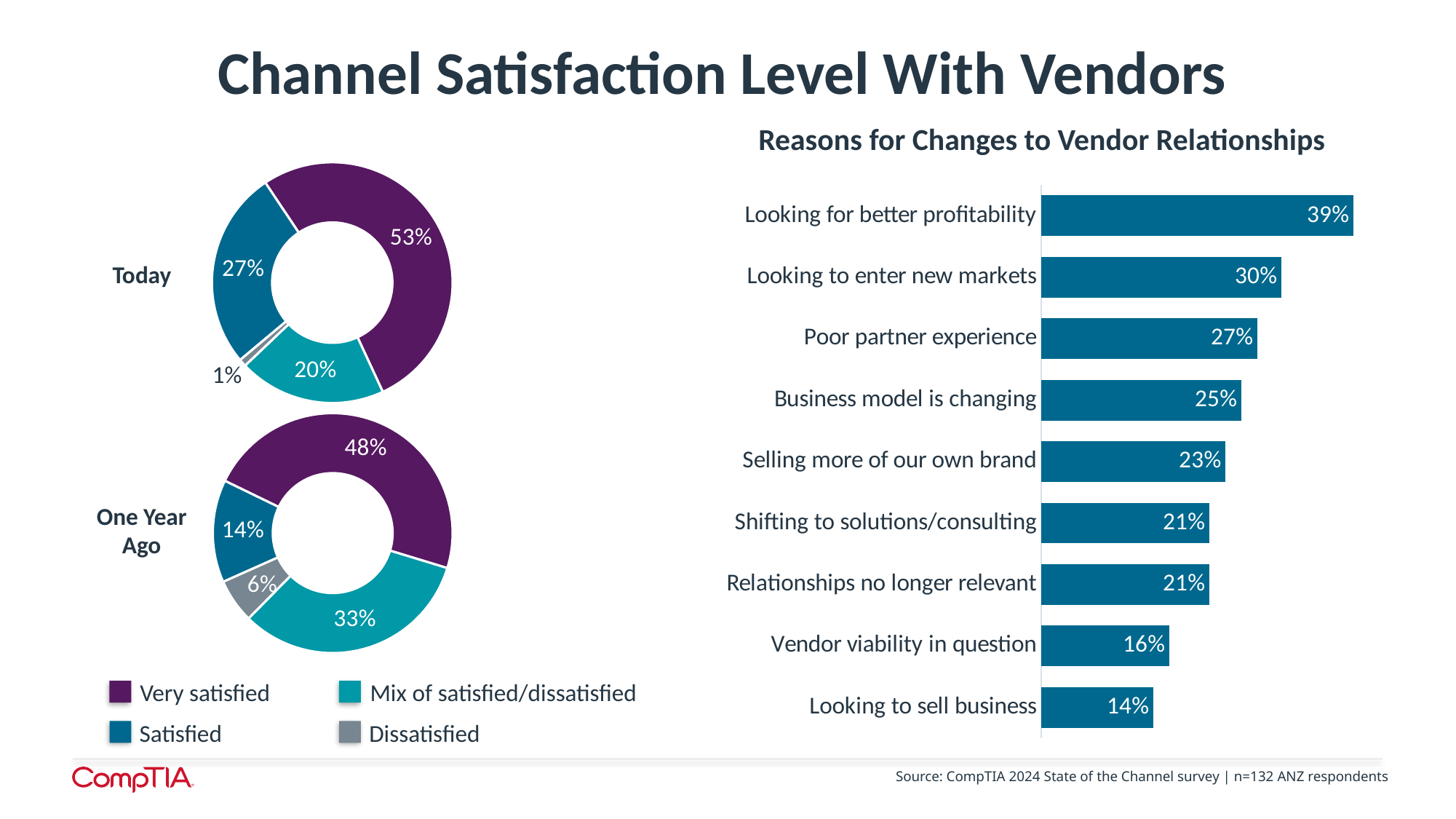
In the 'Reasons for Changes to Vendor Relationships' chart, which reason has the highest value? Looking for better profitability What kind of chart is 'Reasons for Changes to Vendor Relationships'? Bar chart In the 'One Year Ago' donut chart, what percentage is Dissatisfied? 6% In the 'Today' donut chart, what percentage is Very satisfied? 53% What is the difference between the Satisfied share in the 'Today' chart and the Satisfied share in the 'One Year Ago' chart? 13% In the 'Reasons for Changes to Vendor Relationships' chart, which reason has the lowest value? Looking to sell business In the 'Reasons for Changes to Vendor Relationships' chart, what is the value for Poor partner experience? 27% In the 'Today' donut chart, which category has the smallest share? Dissatisfied How many series does the legend for the donut charts list? 4 In the 'Reasons for Changes to Vendor Relationships' chart, how many reasons are listed? 9 In the 'One Year Ago' donut chart, what percentage is Mix of satisfied/dissatisfied? 33% In the 'Reasons for Changes to Vendor Relationships' chart, what is the difference between Looking for better profitability and Looking to enter new markets? 9%